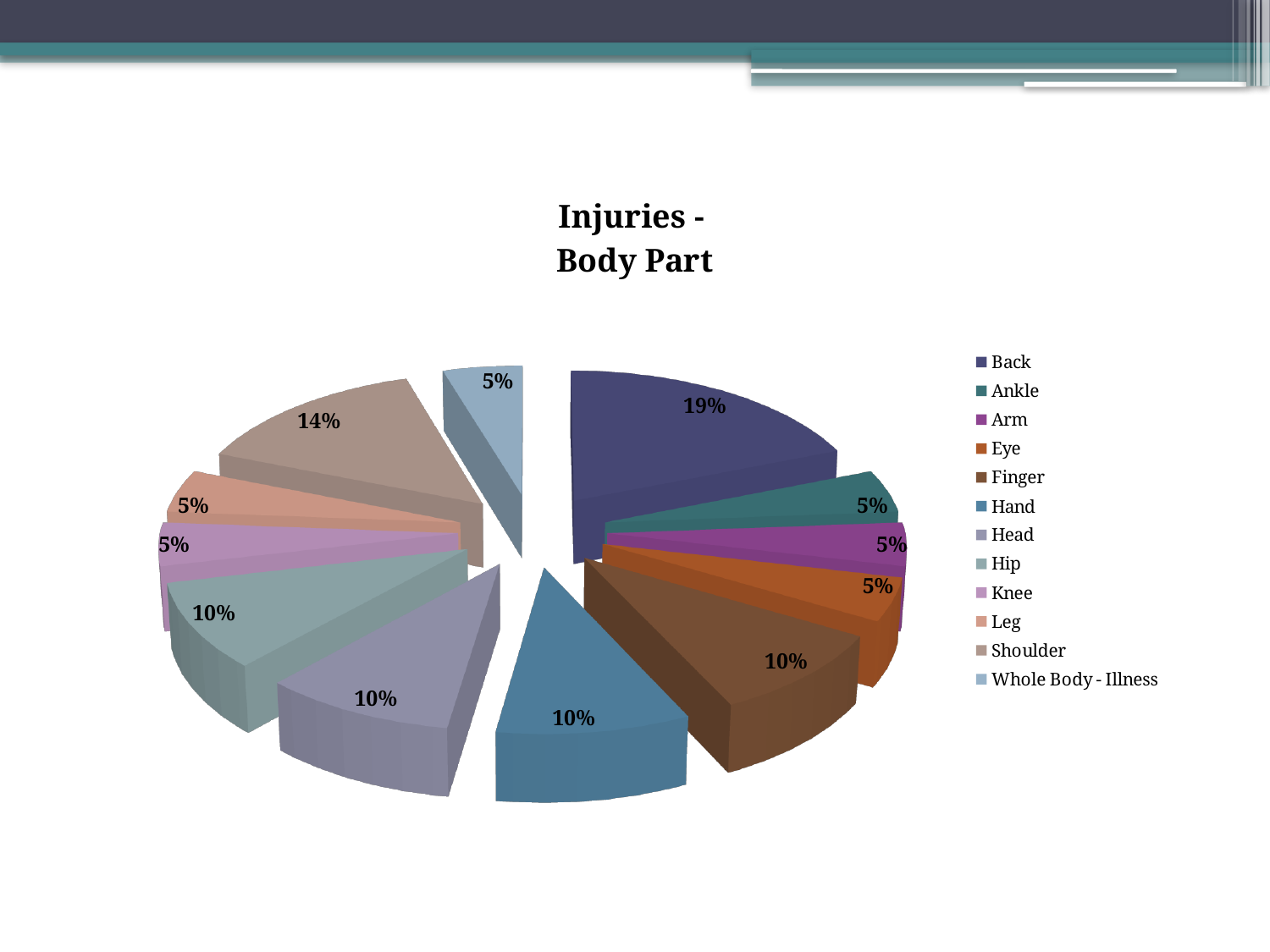
Which has a larger share, Shoulder or Hip? Shoulder What share of injuries is attributed to Finger? 10% What is the title of the chart? Injuries - Body Part What type of chart is shown on the slide? Pie chart Which body part has the largest share of injuries? Back Which has a larger share, Hand or Ankle? Hand What is the difference between the Back share and the Shoulder share? 5% What share of injuries is attributed to Back? 19% What share of injuries is attributed to Whole Body - Illness? 5% What is the difference between the Shoulder share and the Head share? 4% How many categories does the legend list? 12